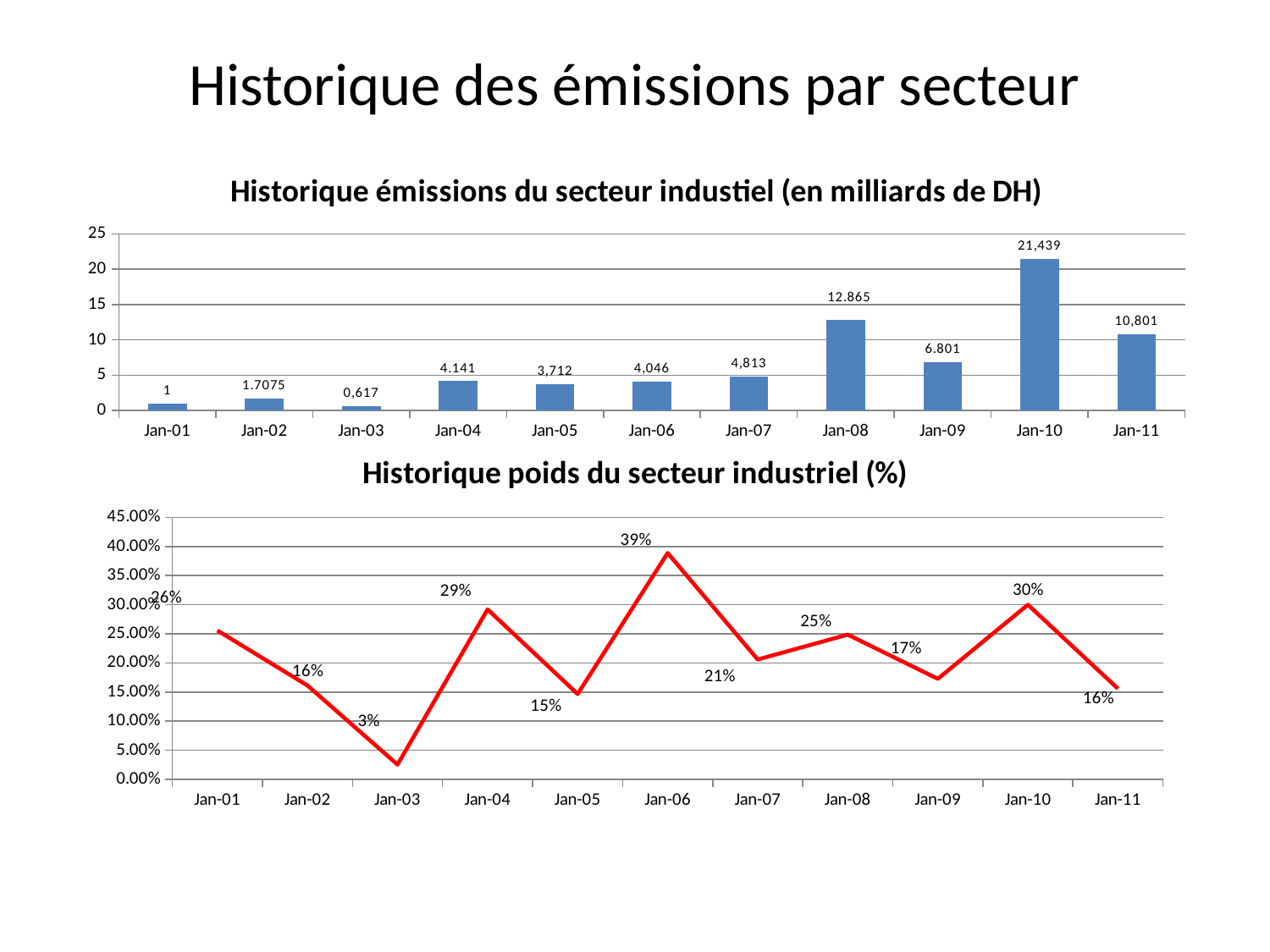
In the top chart (Historique émissions du secteur industiel), which is larger, the value for Jan-09 or the value for Jan-07? Jan-09 What kind of chart is the top chart (Historique émissions du secteur industiel)? Bar chart In the top chart (Historique émissions du secteur industiel), how many bars are plotted? 11 In the top chart (Historique émissions du secteur industiel), what is the difference between the values for Jan-10 and Jan-11? 10,638 In the bottom chart (Historique poids du secteur industriel), what is the value for Jan-06? 39% In the top chart (Historique émissions du secteur industiel), which year has the highest value? Jan-10 In the top chart (Historique émissions du secteur industiel), what is the value for Jan-10? 21,439 In the bottom chart (Historique poids du secteur industriel), what is the difference between the values for Jan-06 and Jan-03? 36% In the bottom chart (Historique poids du secteur industriel), which year has the lowest value? Jan-03 In the top chart (Historique émissions du secteur industiel), which year has the lowest value? Jan-03 In the top chart (Historique émissions du secteur industiel), what is the value for Jan-08? 12.865 What kind of chart is the bottom chart (Historique poids du secteur industriel)? Line chart